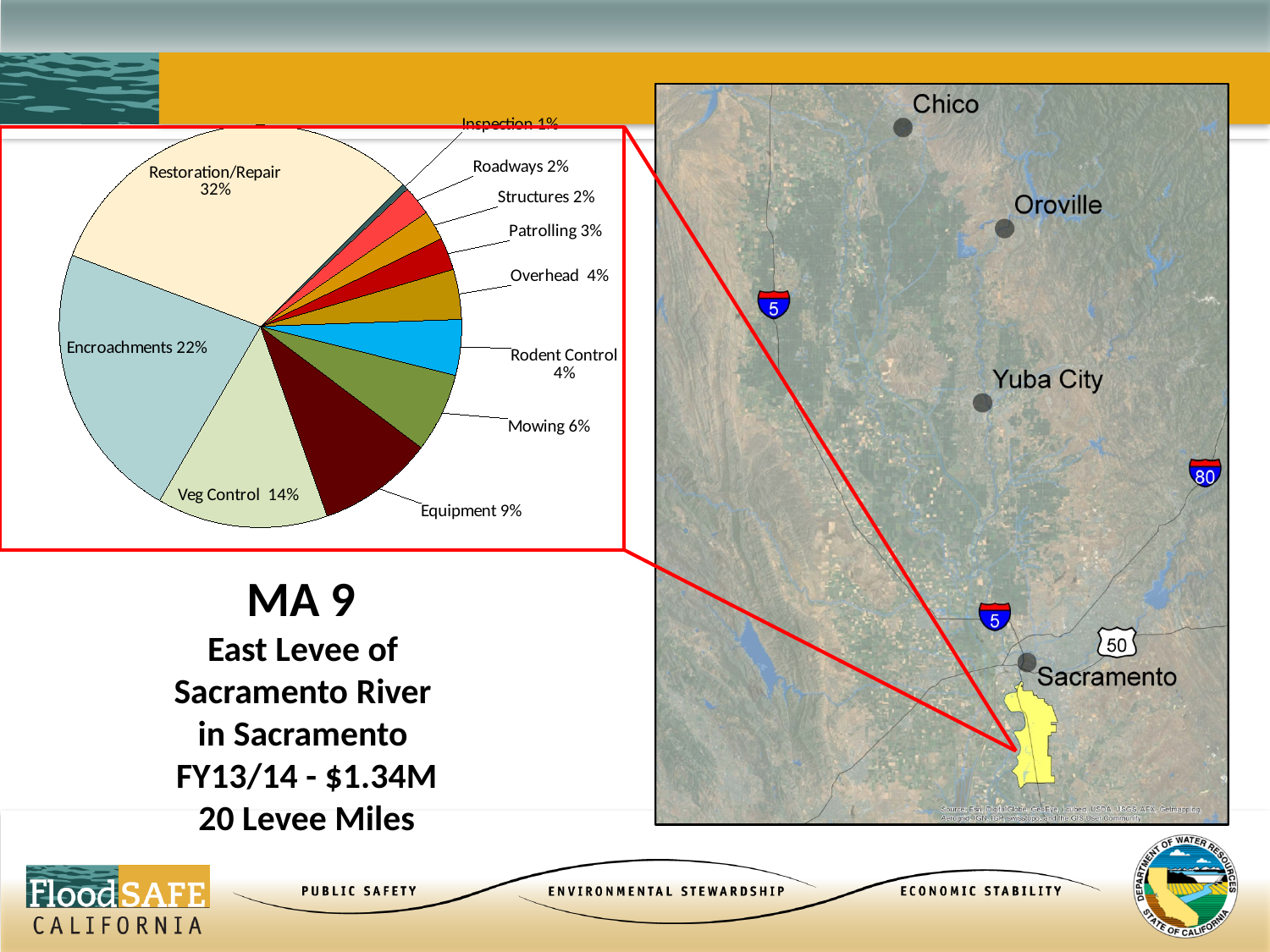
What is the difference between the Restoration/Repair share and the Encroachments share? 10% Which category has the smallest slice of the pie? Inspection What is the value shown for Mowing? 6% What is the value shown for Patrolling? 3% What is the value shown for Encroachments? 22% What is the value shown for Veg Control? 14% How many categories are shown in the pie chart? 11 What share of the pie does Restoration/Repair account for? 32% Which category has the largest slice of the pie? Restoration/Repair Which is larger, the share for Veg Control or the share for Equipment? Veg Control What kind of chart is shown on the slide? pie chart What is the value shown for Equipment? 9%